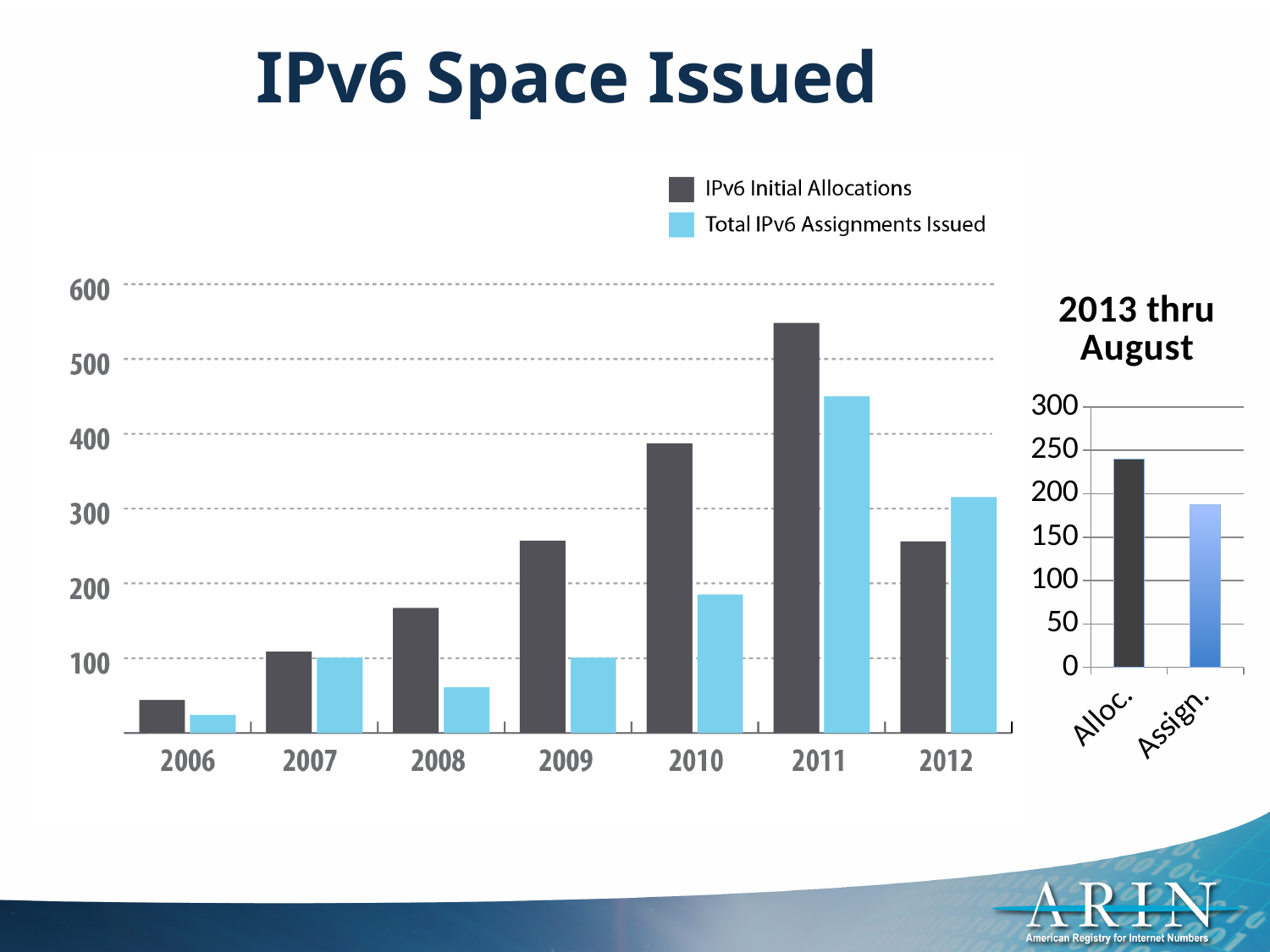
On the main chart titled 'IPv6 Space Issued', in 2012 which is larger: IPv6 Initial Allocations or Total IPv6 Assignments Issued? Total IPv6 Assignments Issued On the main chart titled 'IPv6 Space Issued', in 2008 which is larger: IPv6 Initial Allocations or Total IPv6 Assignments Issued? IPv6 Initial Allocations On the main chart titled 'IPv6 Space Issued', is the value for Total IPv6 Assignments Issued in 2010 greater or less than 200? less On the main chart titled 'IPv6 Space Issued', how many years are shown on the x axis? 7 On the main chart titled 'IPv6 Space Issued', do the IPv6 Initial Allocations values rise or fall from 2006 to 2011? rise On the main chart titled 'IPv6 Space Issued', is the value for IPv6 Initial Allocations in 2011 greater or less than 500? greater On the main chart titled 'IPv6 Space Issued', which year has the highest value for IPv6 Initial Allocations? 2011 On the main chart titled 'IPv6 Space Issued', how many series does the legend list? 2 On the small chart titled '2013 thru August', which category is higher: Alloc. or Assign.? Alloc. On the main chart titled 'IPv6 Space Issued', which year has the lowest value for Total IPv6 Assignments Issued? 2006 On the main chart titled 'IPv6 Space Issued', what kind of chart is shown? bar chart On the small chart titled '2013 thru August', is the value for Alloc. greater or less than 200? greater